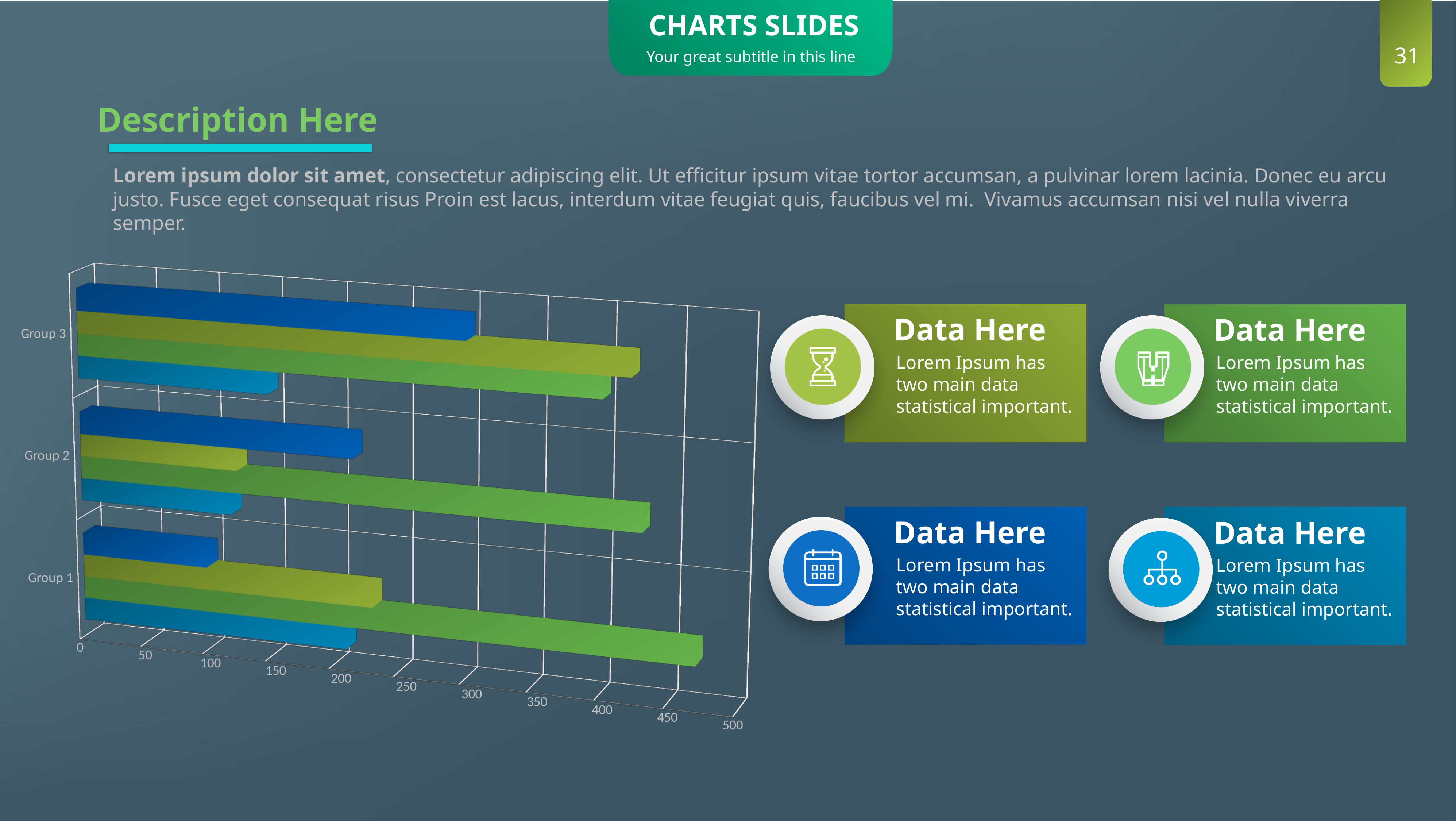
For Group 3, which bar is longer: the olive (yellow-green) bar or the light blue bar? the olive bar Is the value of the dark blue bar for Group 3 greater or less than 250? greater Which group has the shortest dark blue bar? Group 1 How many bars are plotted for each group in the chart? 4 What kind of chart is shown on the slide? bar chart Is the value of the green bar for Group 1 greater or less than 400? greater How many groups (categories) are shown on the chart's vertical axis? 3 What is the highest value labelled on the chart's horizontal axis? 500 Is the value of the olive (yellow-green) bar for Group 2 greater or less than 200? less Which group has the longest dark blue bar? Group 3